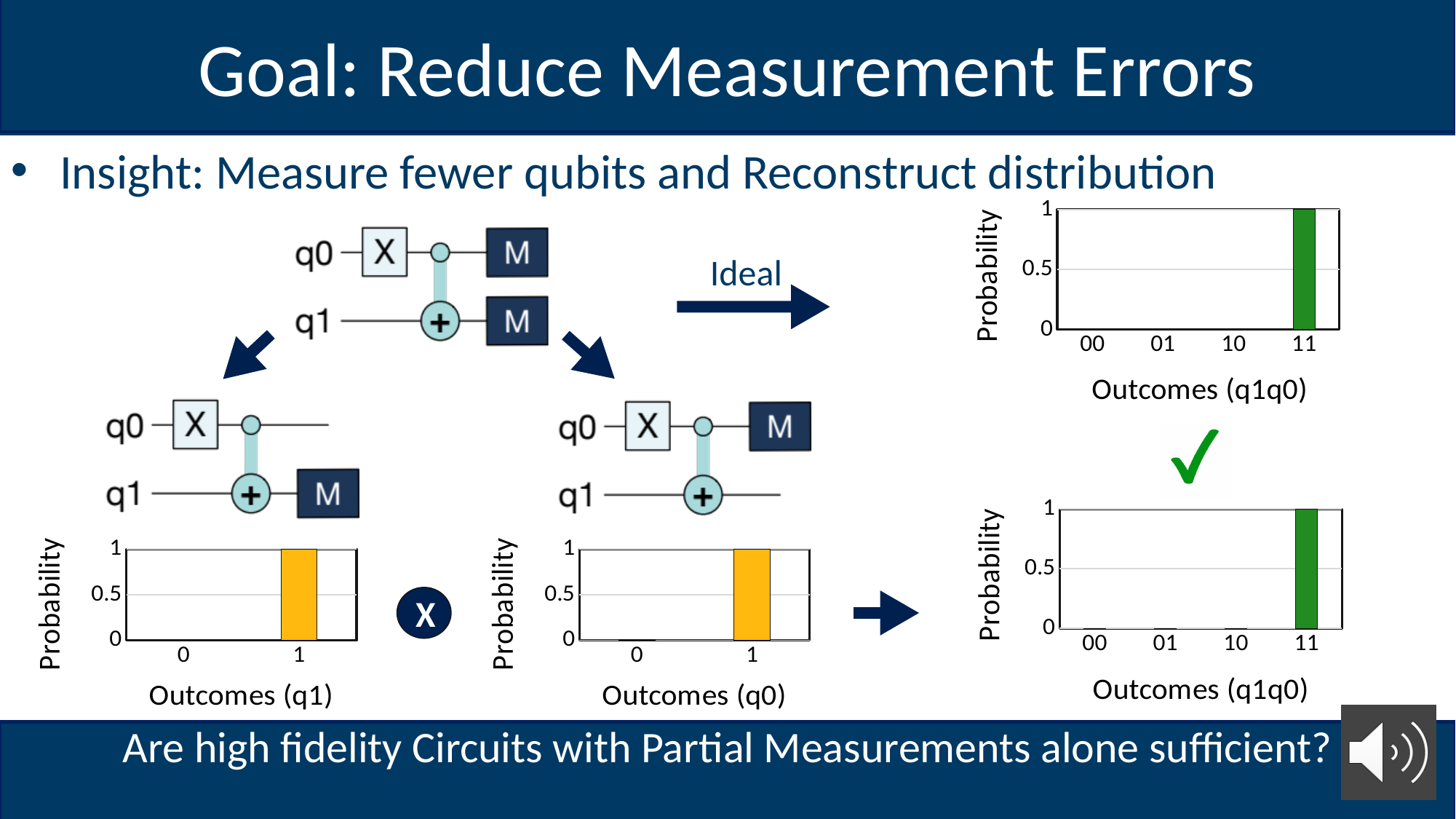
In the bottom-middle chart (Outcomes (q0)), is the probability for outcome 0 greater or less than 0.5? less What colour is the bar in the bottom-right chart (Outcomes (q1q0))? green In the top-right chart (Outcomes (q1q0)), which outcome has the highest probability? 11 In the top-right chart (Outcomes (q1q0)), how many outcome categories are shown on the x axis? 4 In the bottom-right chart (Outcomes (q1q0)), what is the probability for outcome 11? 1 In the bottom-left chart (Outcomes (q1)), which outcome has the highest probability? 1 In the bottom-right chart (Outcomes (q1q0)), is the probability for outcome 01 greater or less than 0.5? less In the bottom-middle chart (Outcomes (q0)), which outcome has the highest probability? 1 What kind of chart is the top-right chart (Outcomes (q1q0))? bar chart In the bottom-left chart (Outcomes (q1)), what is the probability for outcome 1? 1 What is the y-axis label of the bottom-middle chart (Outcomes (q0))? Probability In the bottom-left chart (Outcomes (q1)), how many outcome categories are shown on the x axis? 2